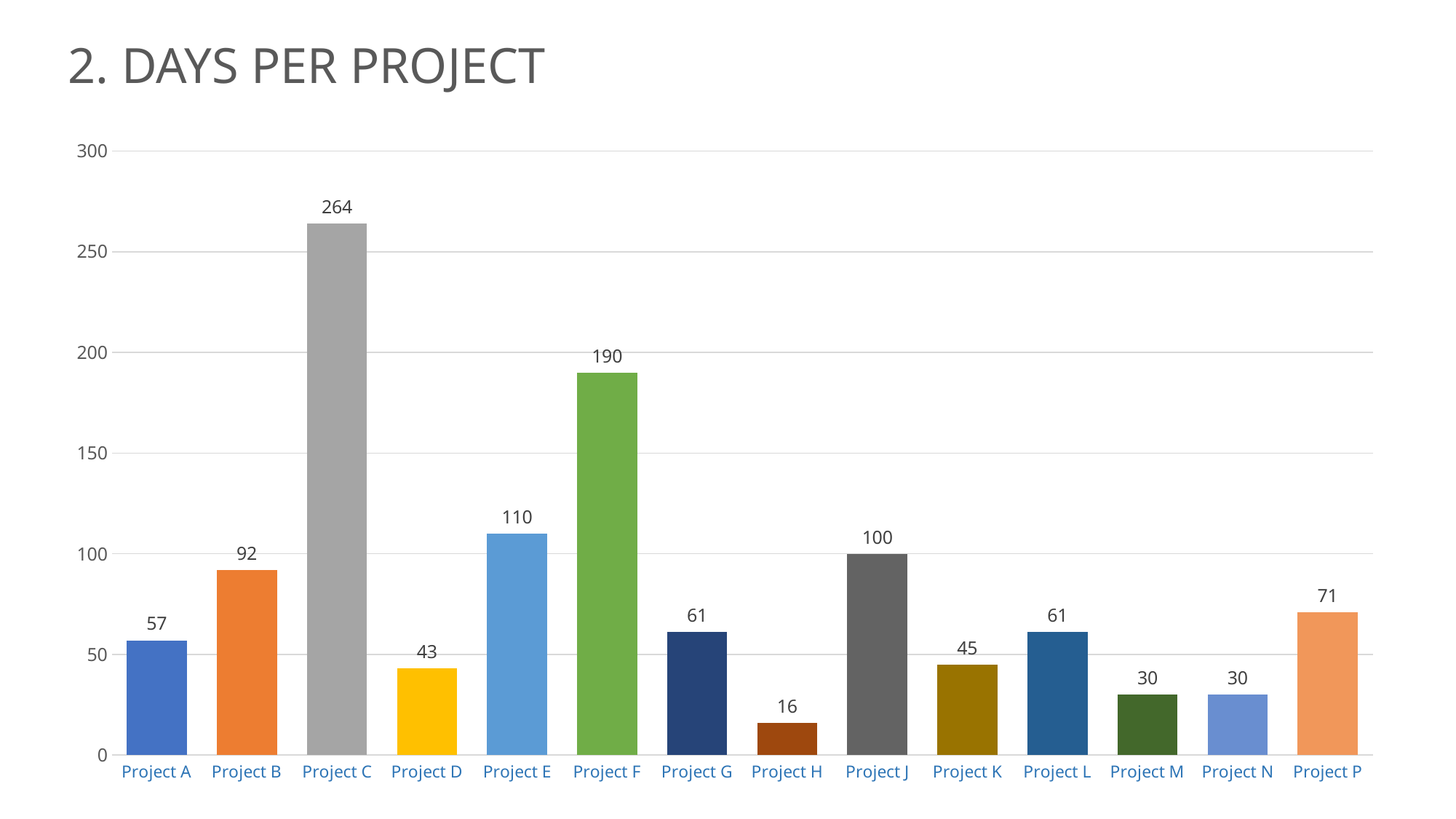
What kind of chart is shown on the slide? Bar chart What is the difference between the values for Project C and Project F? 74 What is the difference between the values for Project E and Project J? 10 How many projects are shown on the chart? 14 What is the value for Project P? 71 What is the value for Project H? 16 What is the title of the slide? 2. DAYS PER PROJECT Which project has the lowest number of days? Project H Which is larger, the value for Project B or the value for Project K? Project B How many days does Project C take? 264 Which project has the highest number of days? Project C Is the value for Project F greater or less than 150? greater